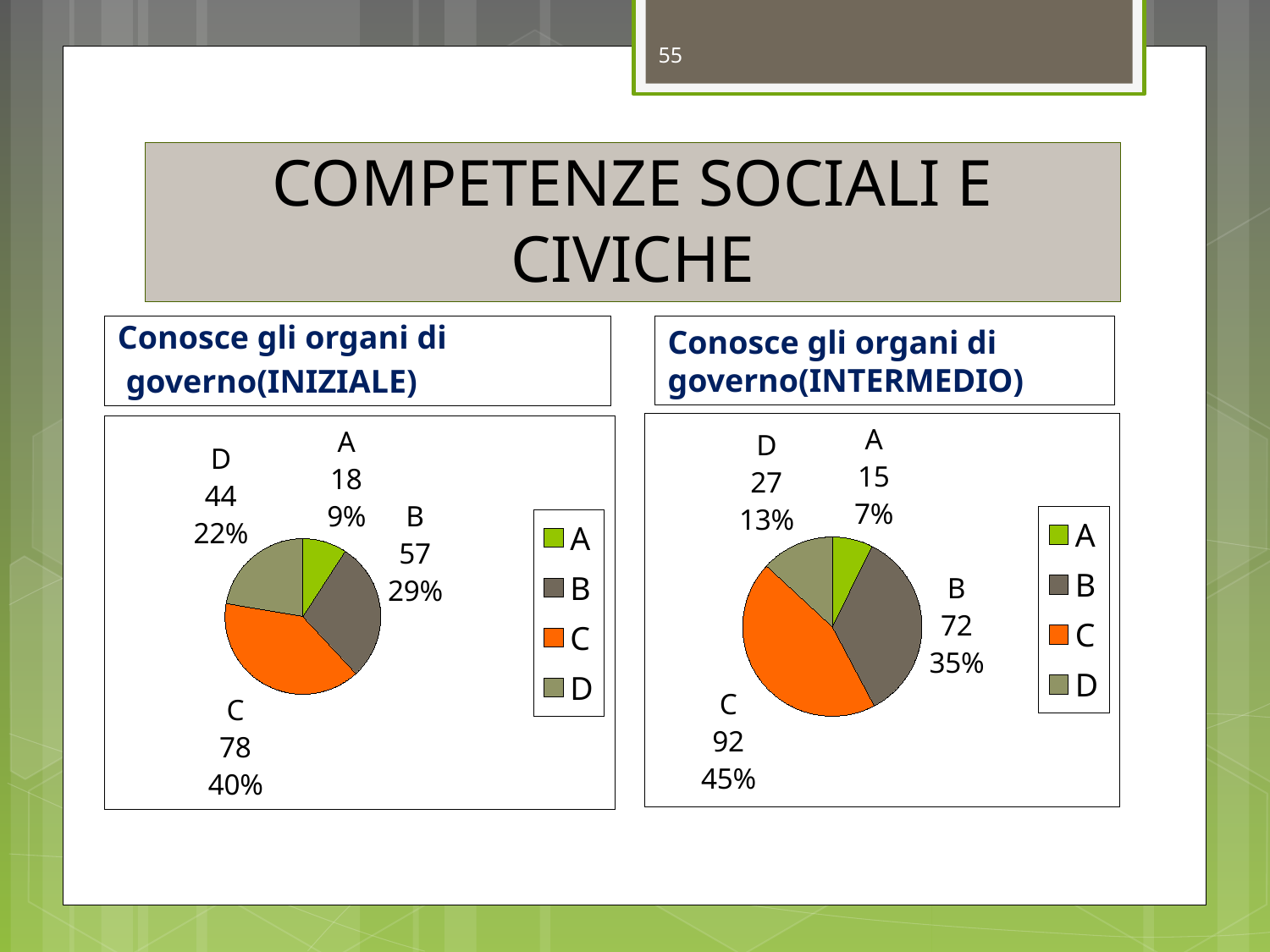
In the 'Conosce gli organi di governo(INTERMEDIO)' chart, what is the value for B? 72 In the 'Conosce gli organi di governo(INIZIALE)' chart, which category has the largest slice? C In the 'Conosce gli organi di governo(INIZIALE)' chart, what is the value for C? 78 In the 'Conosce gli organi di governo(INIZIALE)' chart, which is larger, the value for D or the value for B? B In the 'Conosce gli organi di governo(INTERMEDIO)' chart, what colour is the slice for C? Orange How many categories are shown in the 'Conosce gli organi di governo(INTERMEDIO)' chart? 4 In the 'Conosce gli organi di governo(INTERMEDIO)' chart, which category has the smallest slice? A In the 'Conosce gli organi di governo(INIZIALE)' chart, what is the difference between the values for B and A? 39 In the 'Conosce gli organi di governo(INTERMEDIO)' chart, what is the difference between the values for C and D? 65 What kind of chart is the 'Conosce gli organi di governo(INIZIALE)' chart? Pie chart In the 'Conosce gli organi di governo(INTERMEDIO)' chart, what share of the pie does C represent? 45% In the 'Conosce gli organi di governo(INIZIALE)' chart, what share of the pie does D represent? 22%